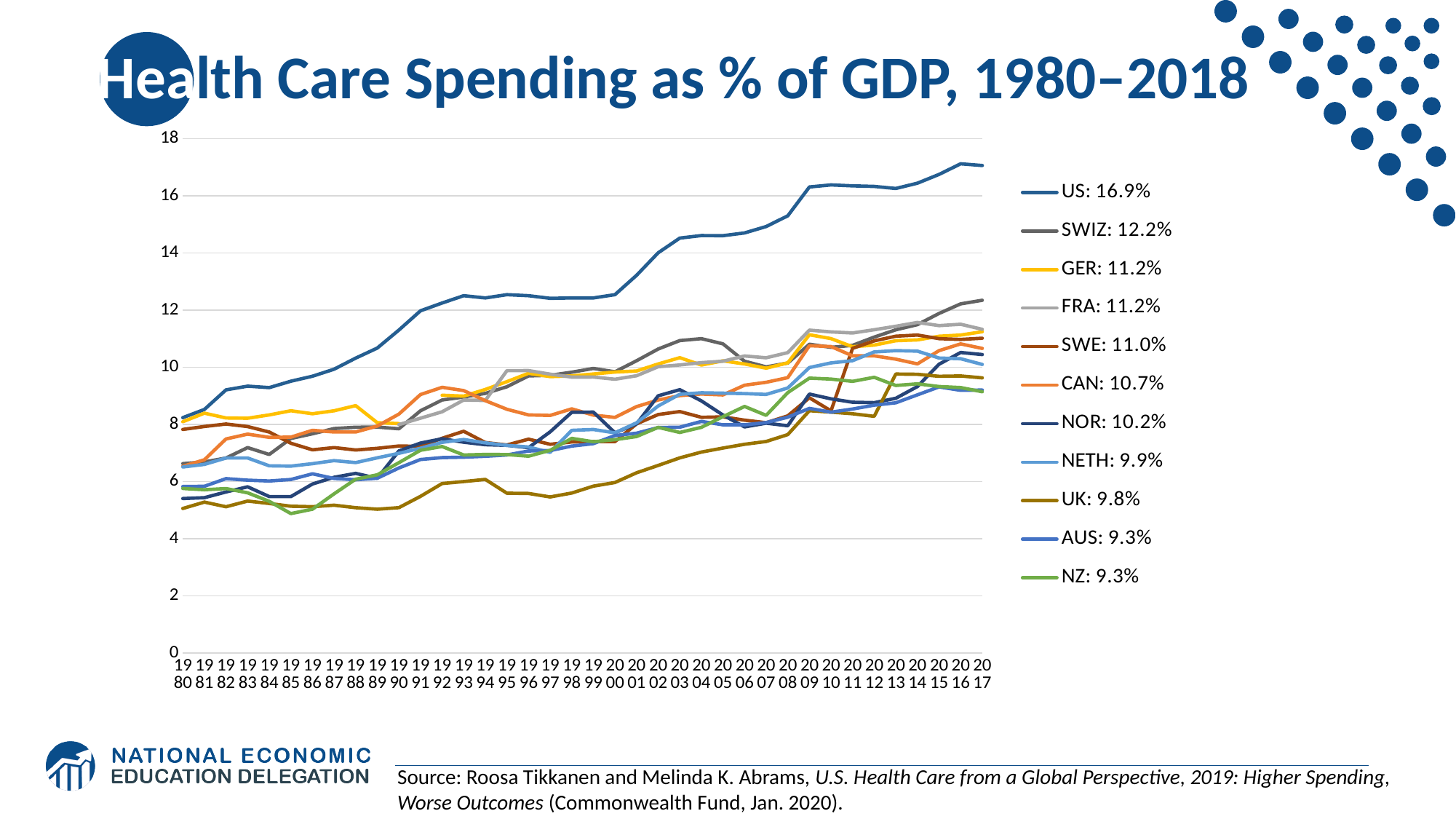
Does the US line generally rise or fall from 1980 to 2017? rise Which country has the highest health care spending as % of GDP according to the legend? US Is the value for the US in 2017 greater or less than 16? greater What kind of chart is shown on the slide? line chart What is the title of the chart? Health Care Spending as % of GDP, 1980–2018 What value does the legend give for SWIZ? 12.2% What is the difference between the legend values for the US and SWIZ? 4.7 percentage points What value does the legend give for CAN? 10.7% Which has the larger legend value, SWIZ or GER? SWIZ How many series does the legend list? 11 What value does the legend give for the US? 16.9% What value does the legend give for UK? 9.8%